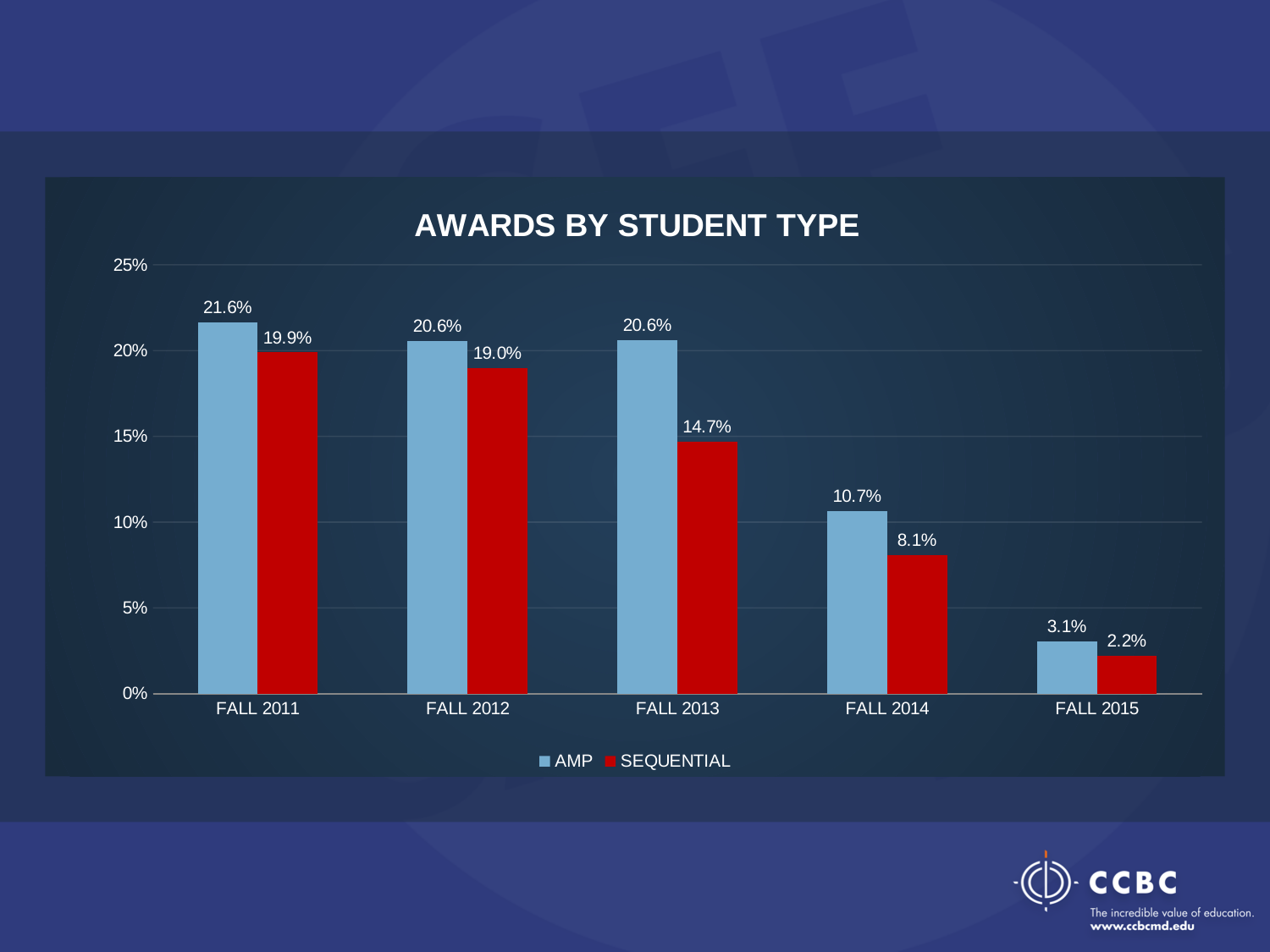
What is the AMP value for FALL 2011? 21.6% Which term has the lowest SEQUENTIAL value? FALL 2015 What kind of chart is shown on the slide? Bar chart What is the AMP value for FALL 2014? 10.7% How many series does the legend list? 2 What is the SEQUENTIAL value for FALL 2013? 14.7% Is the SEQUENTIAL value for FALL 2012 greater or less than 15%? greater Which is larger for FALL 2014, the AMP value or the SEQUENTIAL value? AMP How many terms are shown on the x axis? 5 Which term has the highest AMP value? FALL 2011 Do the AMP values rise or fall from FALL 2011 to FALL 2015? Fall What is the difference between the AMP and SEQUENTIAL values for FALL 2013? 5.9%